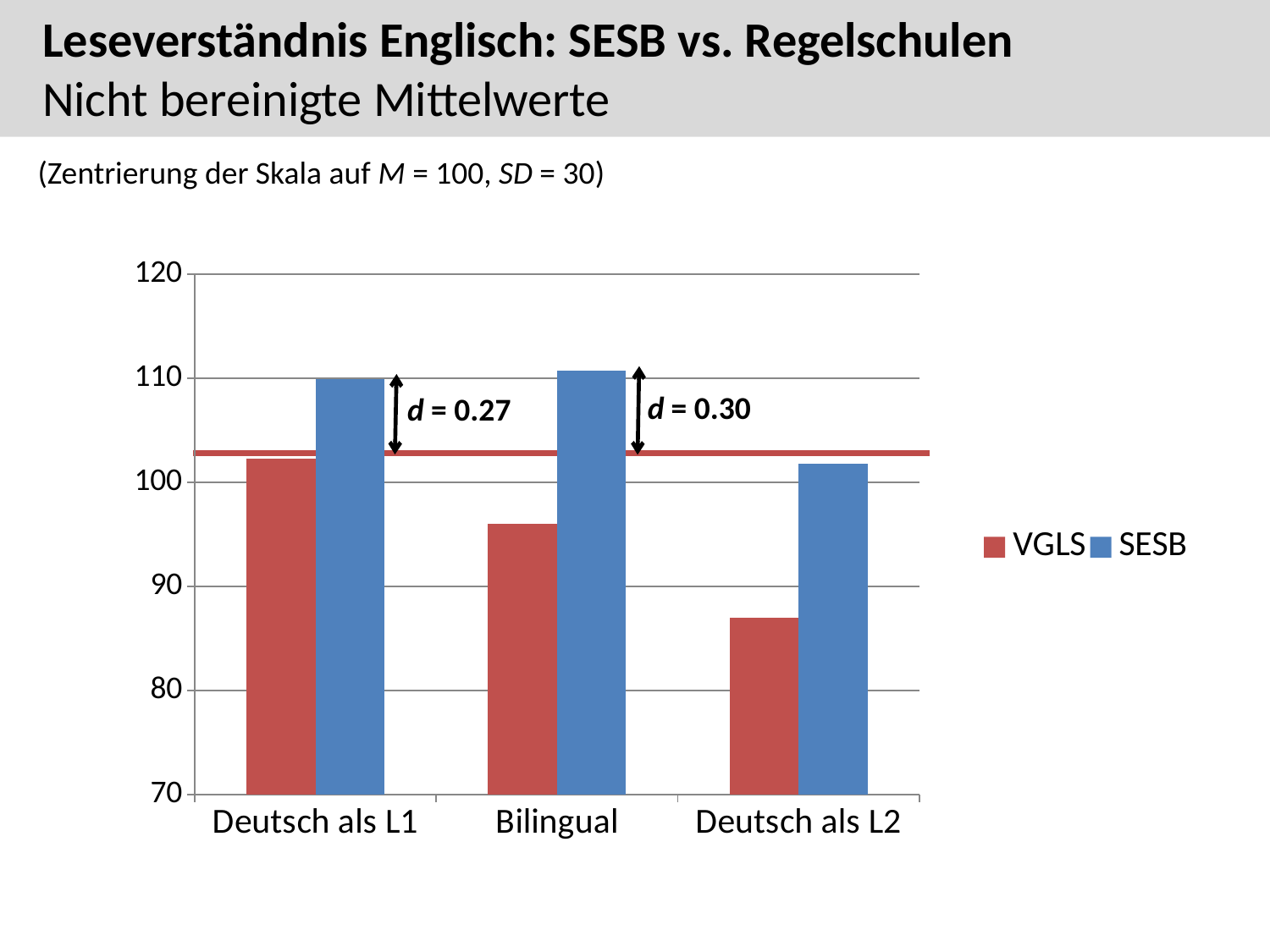
Is the VGLS value for Deutsch als L2 greater or less than 90? less How many categories are shown on the x axis? 3 Which series does the legend list first? VGLS Is the VGLS value for Deutsch als L1 greater or less than 100? greater Which category has the highest VGLS value? Deutsch als L1 What effect size d is printed for the Deutsch als L1 group? d = 0.27 Is the SESB value for Bilingual greater or less than 100? greater What kind of chart is shown on the slide? bar chart Which category has the lowest VGLS value? Deutsch als L2 For Deutsch als L2, which series has the larger value, VGLS or SESB? SESB How many series does the legend list? 2